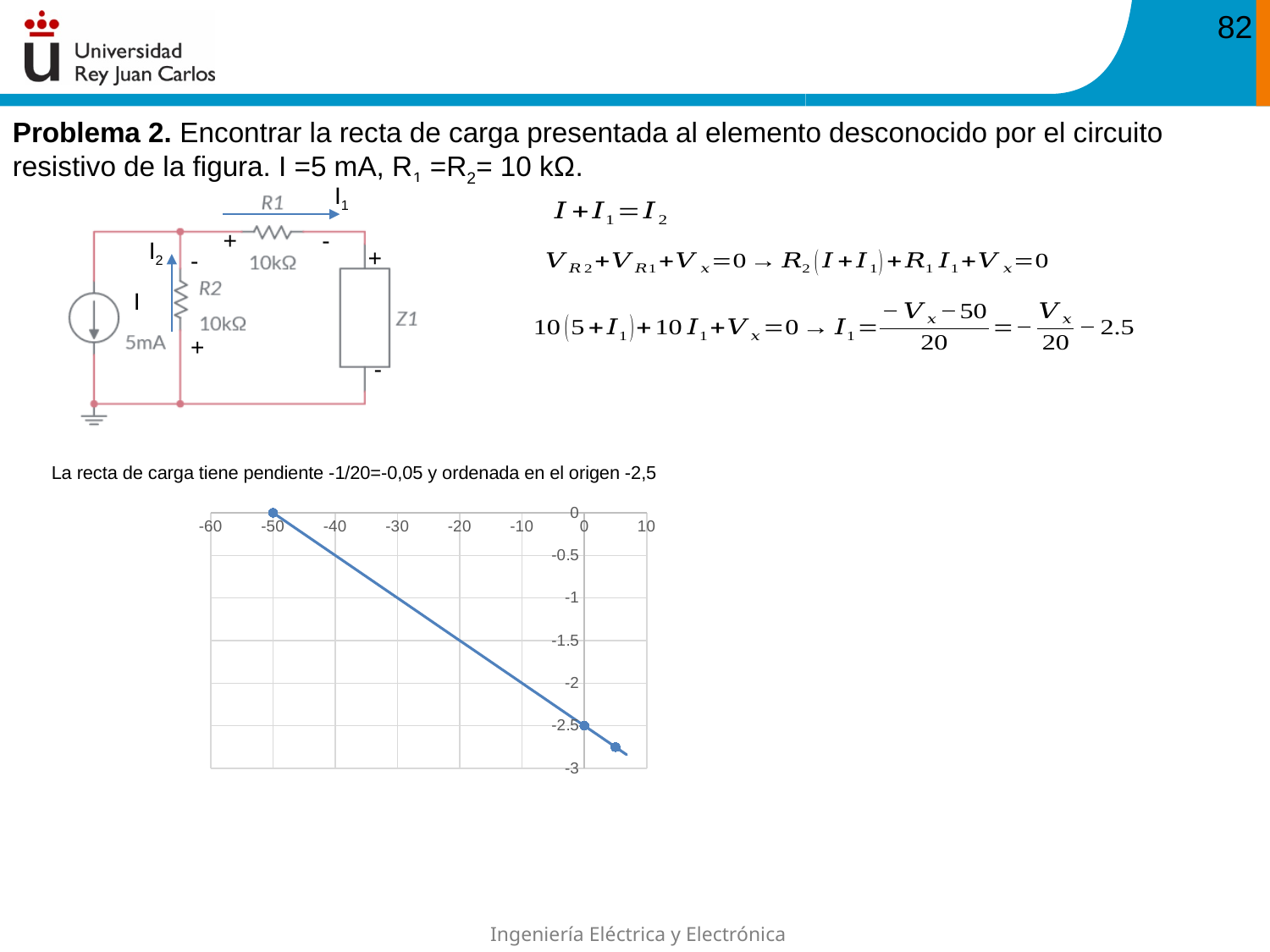
What kind of chart is shown on the slide? line chart What is the lowest value shown on the y axis? -3 Is the value of the line at x = -20 greater or less than -1? less Is the value of the line at x = -40 greater or less than -1? greater As the x-axis value increases from -50 to 0, does the plotted line rise or fall? fall What is the range of the x axis shown on the chart? -60 to 10 How many data point markers are plotted on the line? 3 What is the y value of the plotted line at x = -50? 0 What is the y value of the plotted line at x = 0? -2.5 Is the value of the line at x = -10 greater or less than -1.5? less Which has the higher y value on the line: the point at x = -50 or the point at x = 0? x = -50